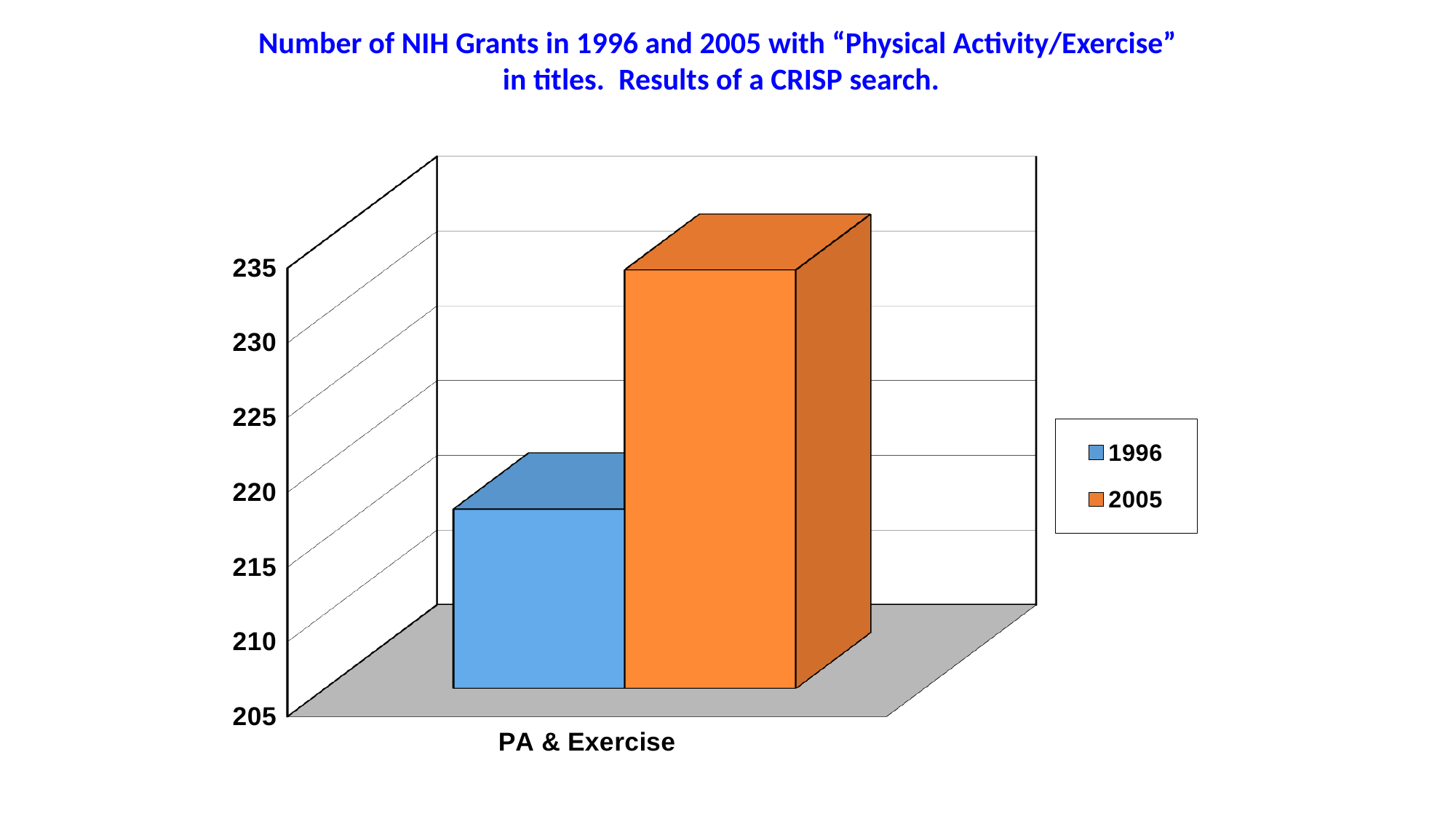
Which series has the higher value for PA & Exercise, 1996 or 2005? 2005 How many series does the legend list? 2 Which colour represents the 2005 series in the legend? Orange What kind of chart is shown on the slide? Bar chart What is the label of the category on the x axis? PA & Exercise Which year has the highest number of grants for PA & Exercise? 2005 How many categories are shown on the x axis? 1 Is the value for 1996 greater or less than 225? less Is the value for 1996 greater or less than 210? greater Is the value for 2005 greater or less than 230? greater Which year has the lowest number of grants for PA & Exercise? 1996